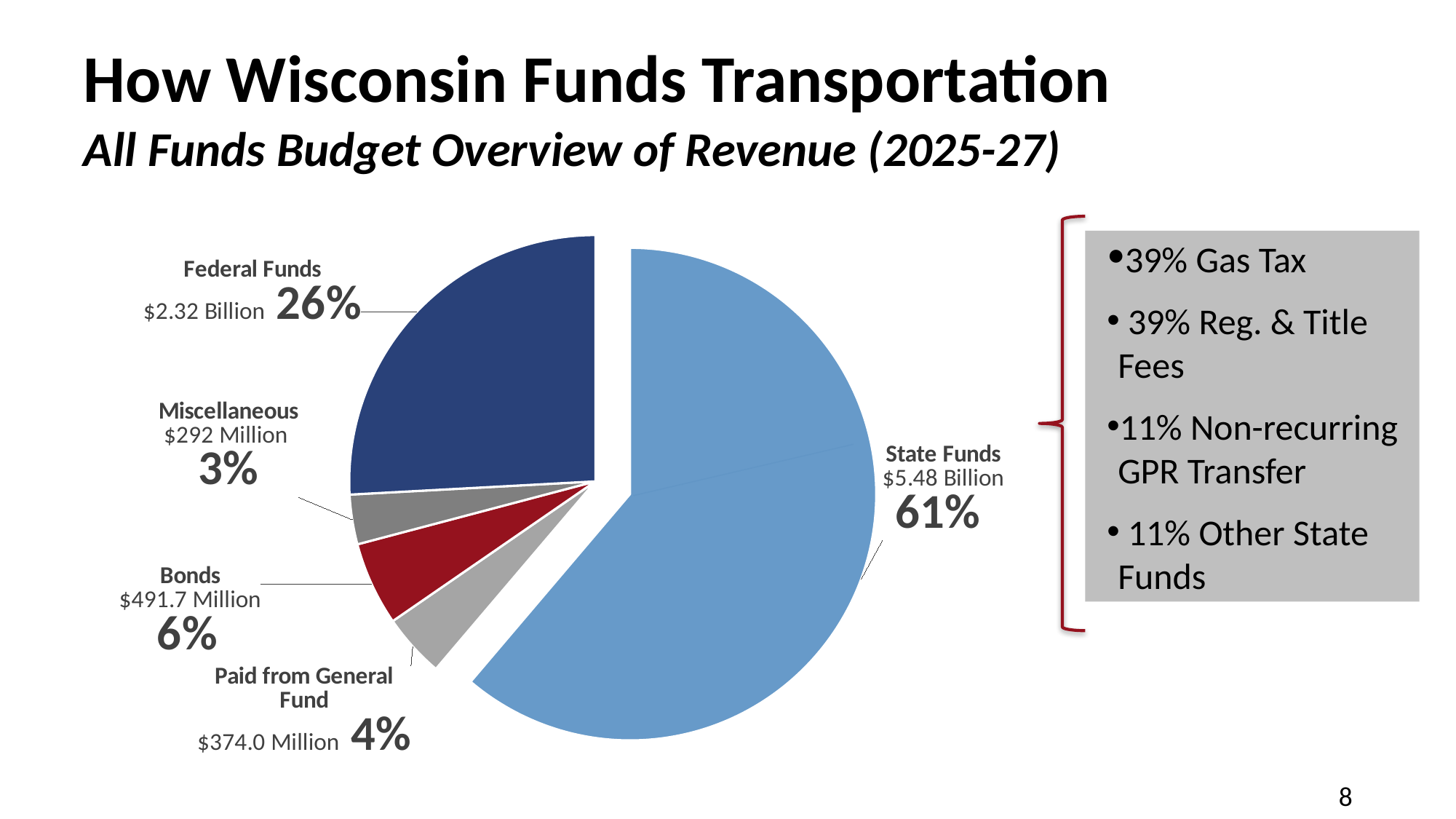
What percentage of the pie is Paid from General Fund? 4% What is the dollar value shown for Federal Funds? $2.32 Billion What share of the pie does State Funds represent? 61% What is the dollar value shown for Miscellaneous? $292 Million How many slices does the pie chart have? 5 Which category has the largest slice of the pie? State Funds What colour is the State Funds slice? Light blue What is the dollar value shown for Bonds? $491.7 Million Which is larger, the share for Bonds or the share for Paid from General Fund? Bonds Which category has the smallest slice of the pie? Miscellaneous What is the difference in percentage points between the State Funds share and the Federal Funds share? 35 What kind of chart is shown on the slide? Pie chart